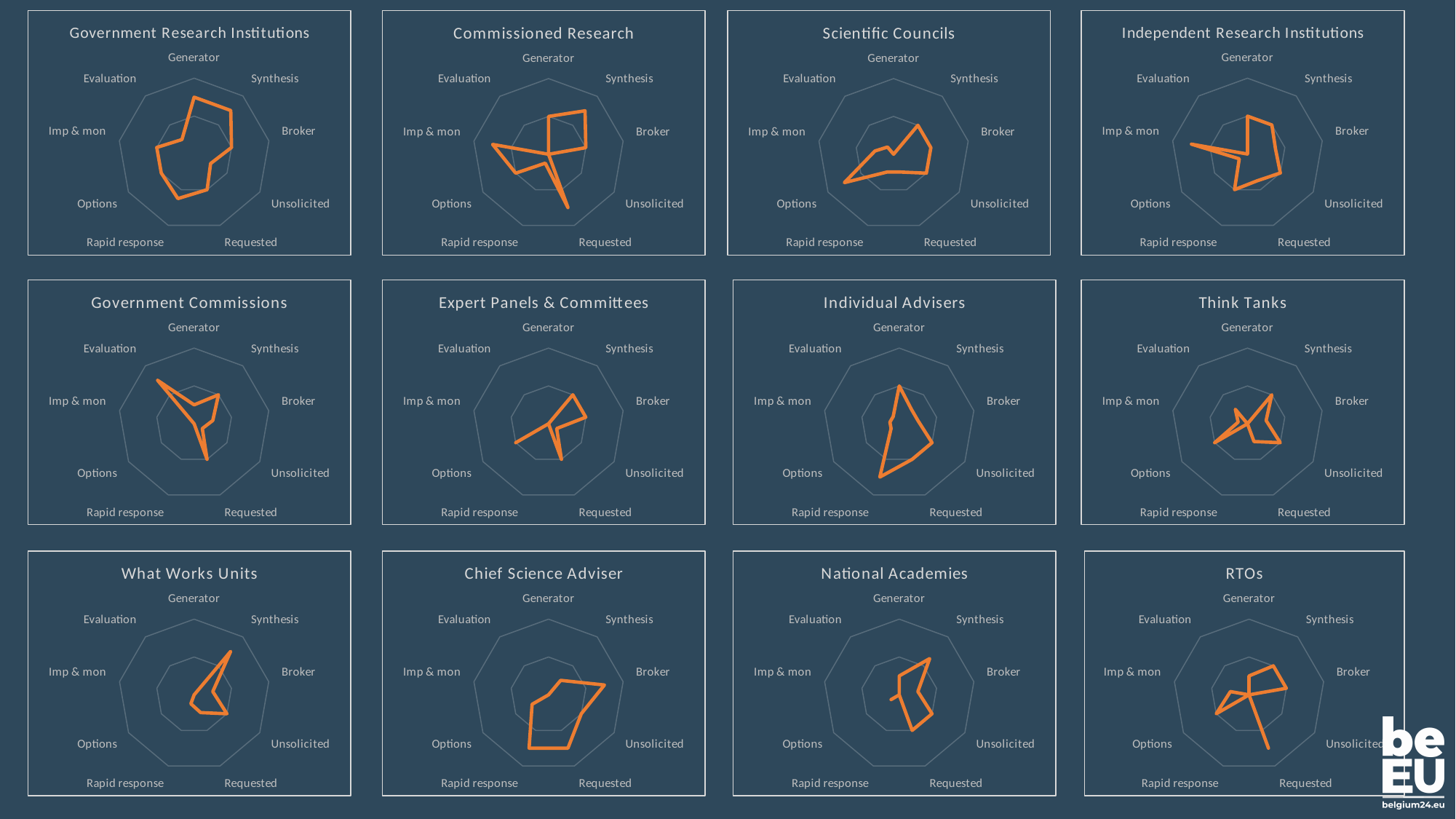
What colour is the data line plotted in the radar charts? Orange What is the title of the chart in the top-left corner of the slide? Government Research Institutions In the Individual Advisers chart, which category has the highest value? Rapid response What kind of chart is used in each of the panels on this slide? Radar chart How many axes (categories) does the Government Research Institutions radar chart have? 9 In the Government Commissions chart, which category has the highest value? Evaluation In the RTOs chart, which category has the highest value? Requested In the Commissioned Research chart, which is larger: the value for Requested or the value for Unsolicited? Requested How many radar charts are shown on the slide? 12